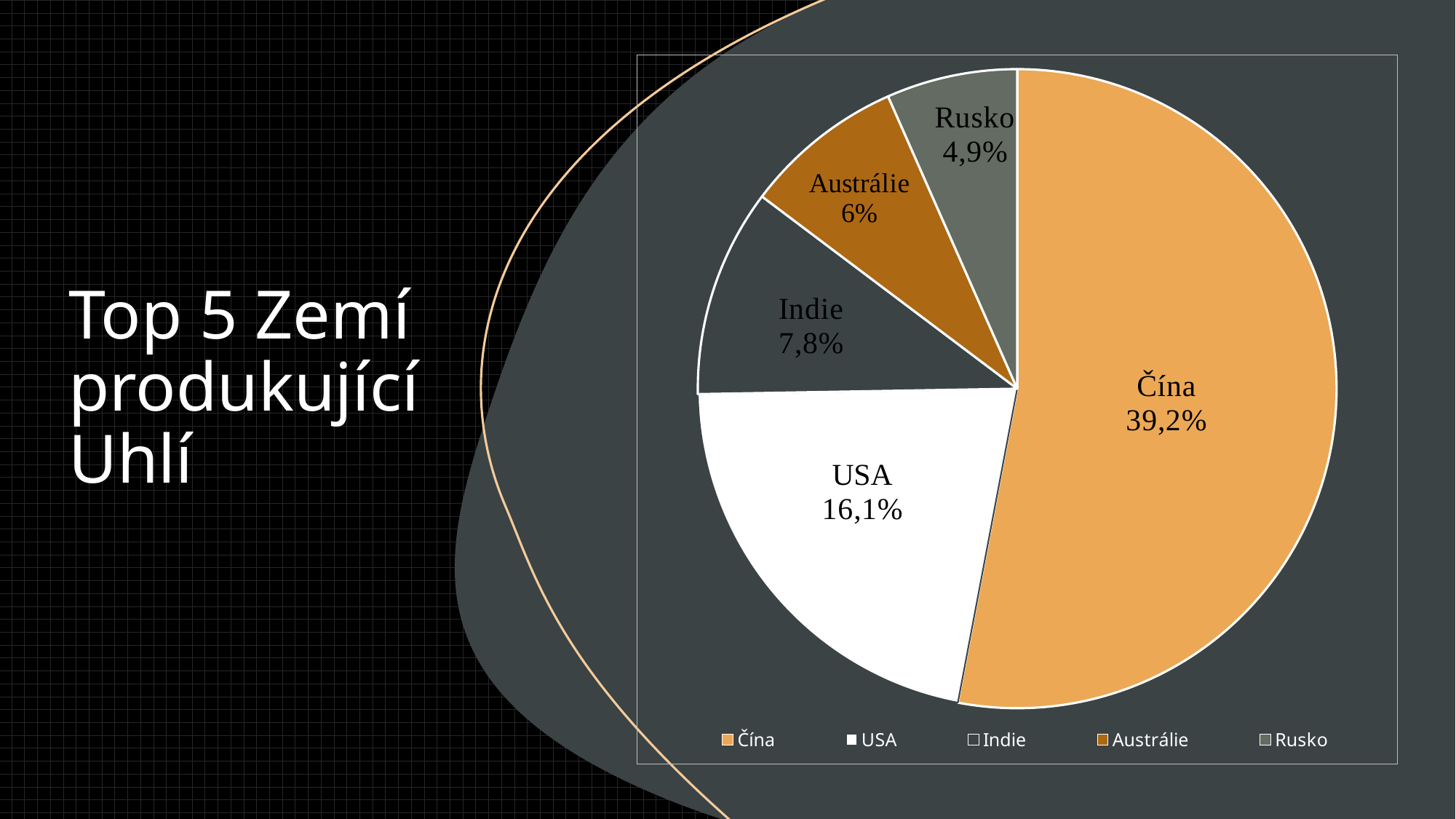
What value is shown for Indie? 7,8% What value is shown for Austrálie? 6% Which is larger, the value for Indie or the value for Austrálie? Indie How many countries are shown in the pie chart? 5 What is the title of the slide containing the chart? Top 5 Zemí produkující Uhlí What is the difference between the values for Čína and USA? 23,1% Which country has the largest slice of the pie? Čína Which country has the smallest slice of the pie? Rusko What value is shown for Čína? 39,2% What value is shown for Rusko? 4,9% What kind of chart is shown on the slide? pie chart What value is shown for USA? 16,1%